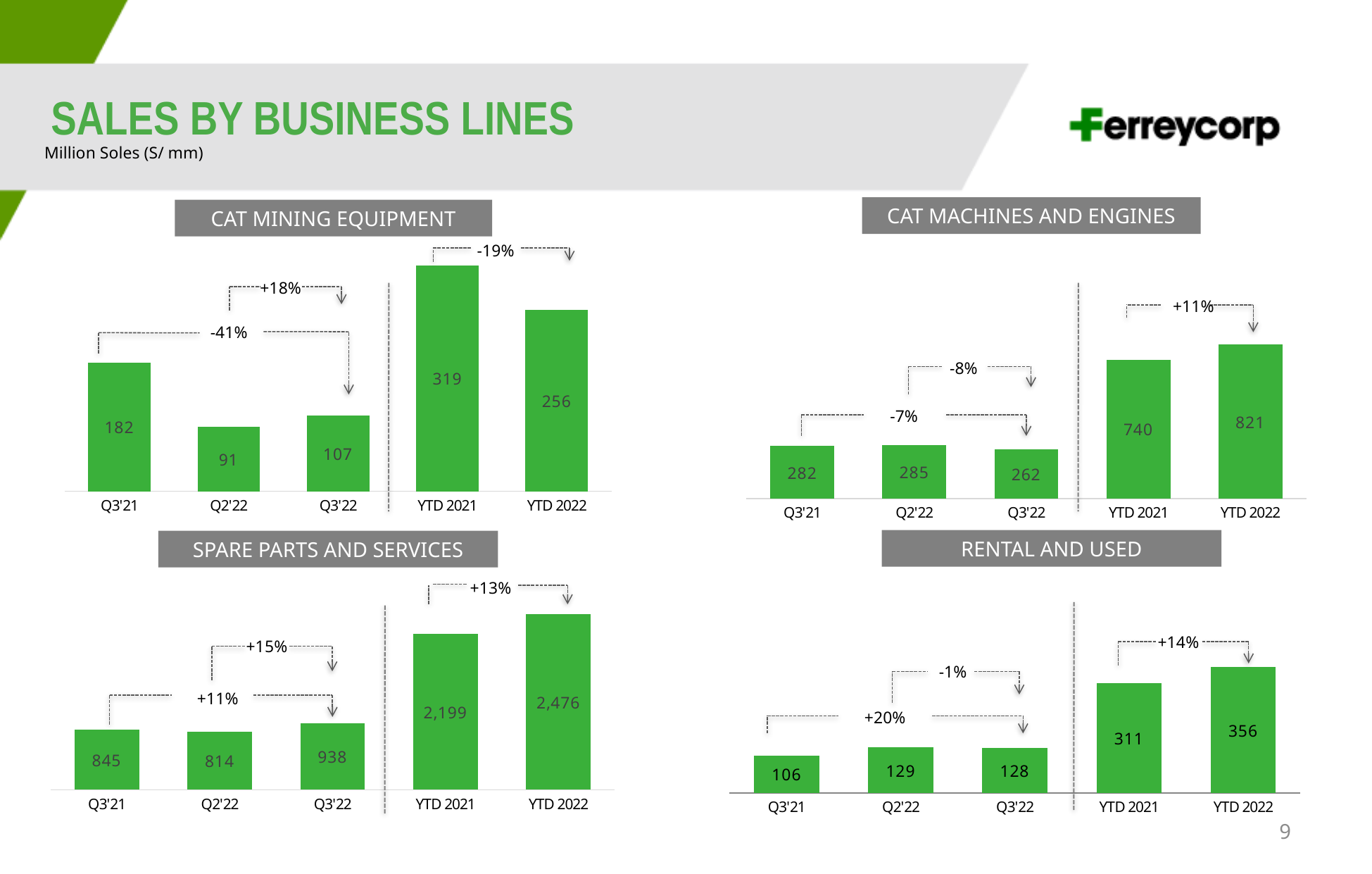
In the CAT MINING EQUIPMENT chart, which category has the lowest value? Q2'22 In the CAT MACHINES AND ENGINES chart, which is larger, Q2'22 or Q3'22? Q2'22 In the RENTAL AND USED chart, which category has the highest value? YTD 2022 In the RENTAL AND USED chart, what is the value for Q3'21? 106 In the SPARE PARTS AND SERVICES chart, what is the value for YTD 2022? 2,476 In the SPARE PARTS AND SERVICES chart, what is the difference between Q3'22 and Q2'22? 124 What type of chart is used for SPARE PARTS AND SERVICES? Bar chart In the CAT MACHINES AND ENGINES chart, what percentage change is shown between YTD 2021 and YTD 2022? +11% In the CAT MINING EQUIPMENT chart, what is the difference between YTD 2021 and YTD 2022? 63 How many bars are plotted in the RENTAL AND USED chart? 5 In the CAT MACHINES AND ENGINES chart, what is the value for YTD 2022? 821 In the CAT MINING EQUIPMENT chart, what is the value for Q3'21? 182